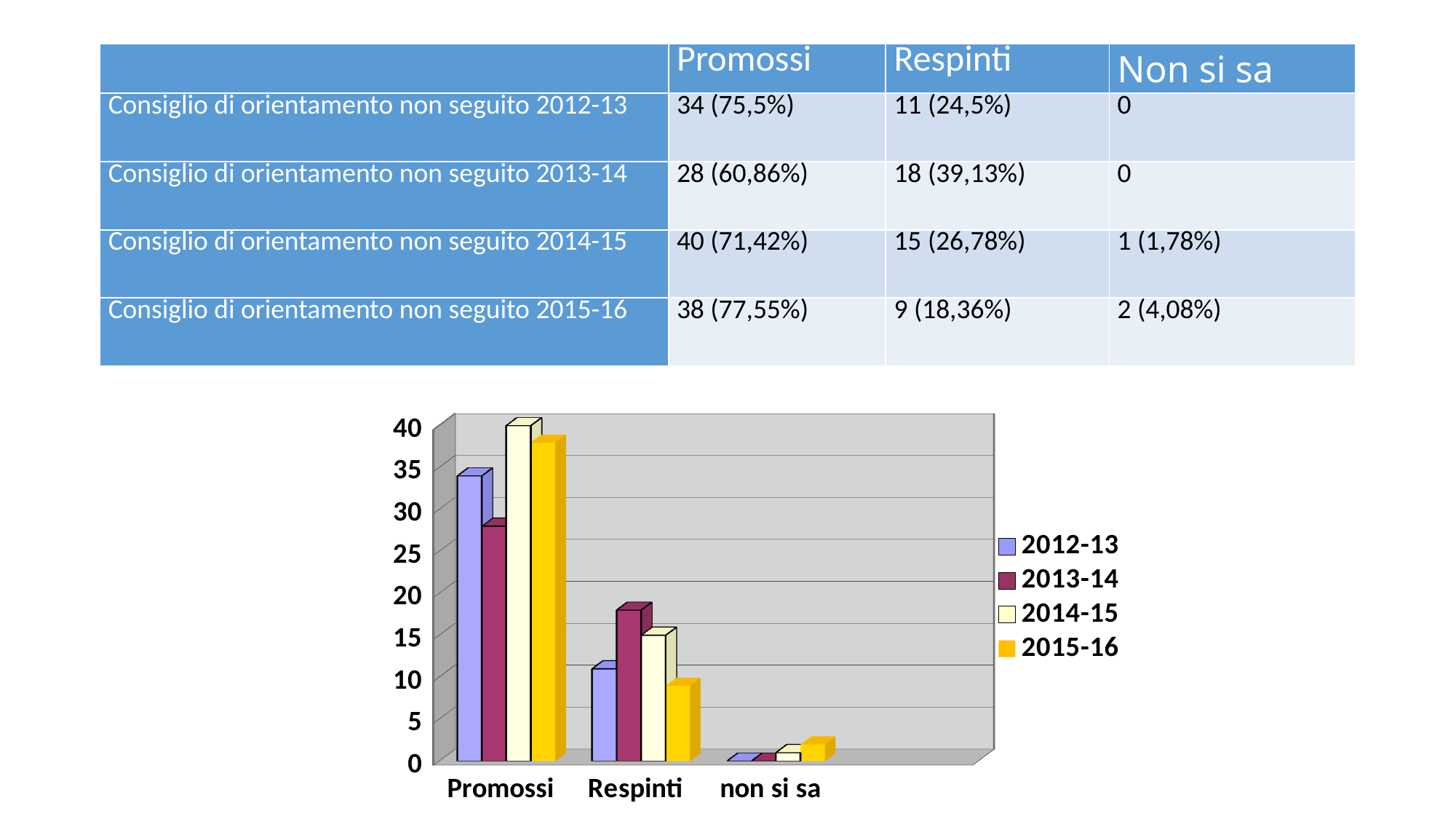
How many series does the chart legend list? 4 How many categories are shown on the x axis of the chart? 3 Which series has the highest bar in the Respinti category? 2013-14 Which series has the highest bar in the Promossi category? 2014-15 Which series has the lowest bar in the Promossi category? 2013-14 Is the value for 2012-13 in the Respinti category greater or less than 15? less What kind of chart is shown on the slide? bar chart Which series has the lowest bar in the Respinti category? 2015-16 Is the value for 2015-16 in the Promossi category greater or less than 35? greater In the Respinti category, is the bar for 2014-15 larger or smaller than the bar for 2015-16? larger What is the number of Promossi for 2014-15, as printed in the table? 40 What colour represents the 2015-16 series in the chart legend? yellow/orange